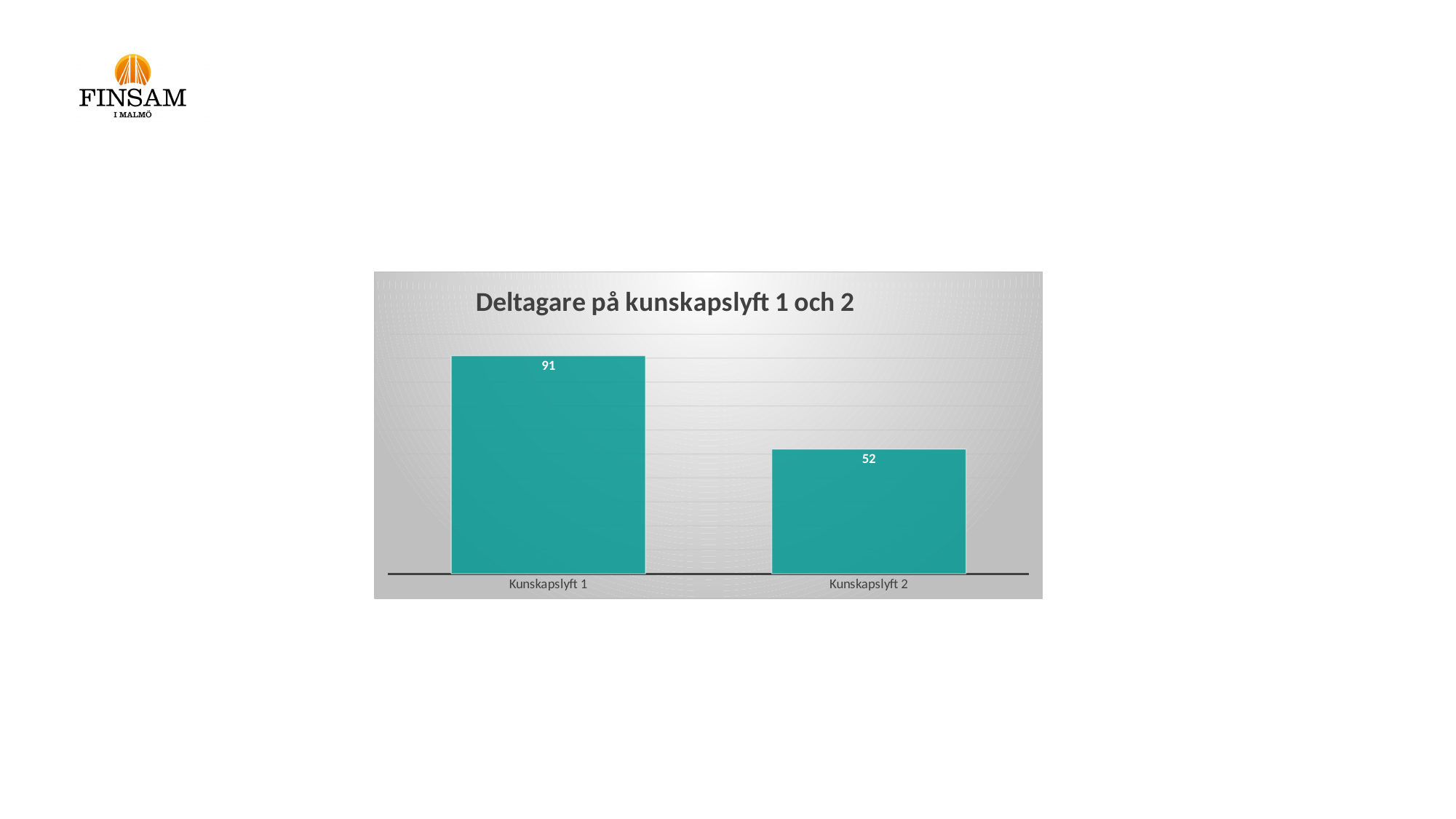
Do the values rise or fall from Kunskapslyft 1 to Kunskapslyft 2? Fall Which is larger, the value for Kunskapslyft 1 or Kunskapslyft 2? Kunskapslyft 1 How many categories are shown in the chart? 2 What is the value for Kunskapslyft 1? 91 Which category has the lowest value? Kunskapslyft 2 What is the title of the chart? Deltagare på kunskapslyft 1 och 2 What is the difference between the values for Kunskapslyft 1 and Kunskapslyft 2? 39 What is the value for Kunskapslyft 2? 52 What kind of chart is shown on the slide? Bar chart What colour are the bars in the chart? Teal Which category has the highest value? Kunskapslyft 1